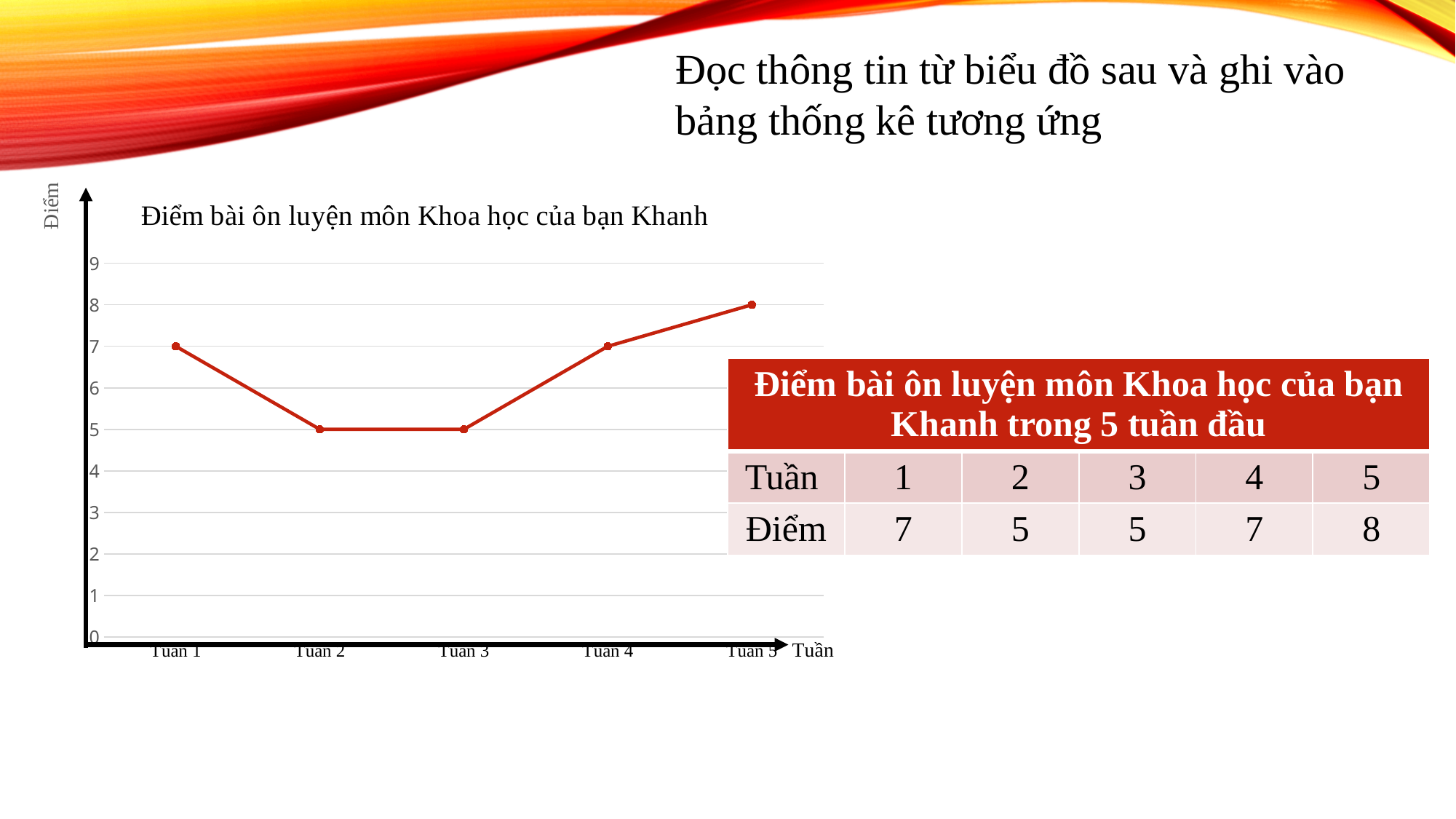
What is the difference between the score in Tuần 5 and the score in Tuần 3? 3 What label is shown on the vertical axis of the chart? Điểm Is the value for Tuần 5 greater or less than 6? greater What kind of chart is shown on the slide? line chart What is the score for Tuần 2? 5 What is the score for Tuần 1? 7 How many weeks (points) are plotted on the chart? 5 What is the score for Tuần 5? 8 What is the title of the chart? Điểm bài ôn luyện môn Khoa học của bạn Khanh Which week has the highest score? Tuần 5 Which is larger, the score for Tuần 4 or the score for Tuần 2? Tuần 4 Do the scores rise or fall from Tuần 3 to Tuần 5? rise